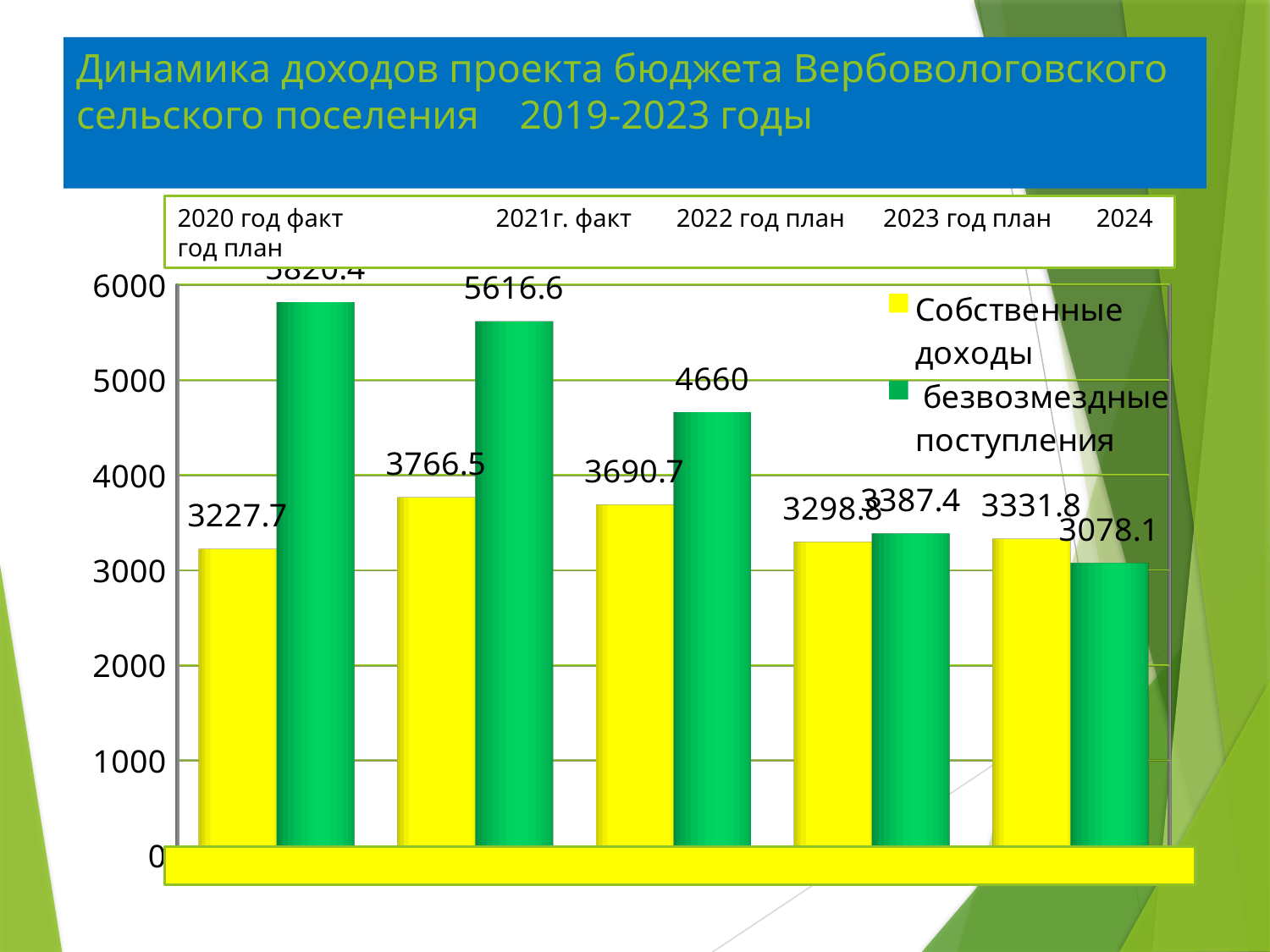
How many series does the legend list? 2 In which year are Собственные доходы the highest? 2021г. факт How many year categories are shown on the chart? 5 What is the value of Собственные доходы for 2021г. факт? 3766.5 For 2023 год план, which is larger: Собственные доходы or безвозмездные поступления? безвозмездные поступления For 2022 год план, what is the difference between безвозмездные поступления and Собственные доходы? 969.3 What is the value of Собственные доходы for 2020 год факт? 3227.7 In which year are безвозмездные поступления the highest? 2020 год факт What is the value of безвозмездные поступления for 2022 год план? 4660 What type of chart is shown on the slide? Bar chart What is the value of безвозмездные поступления for 2024 год план? 3078.1 In which year are Собственные доходы the lowest? 2020 год факт